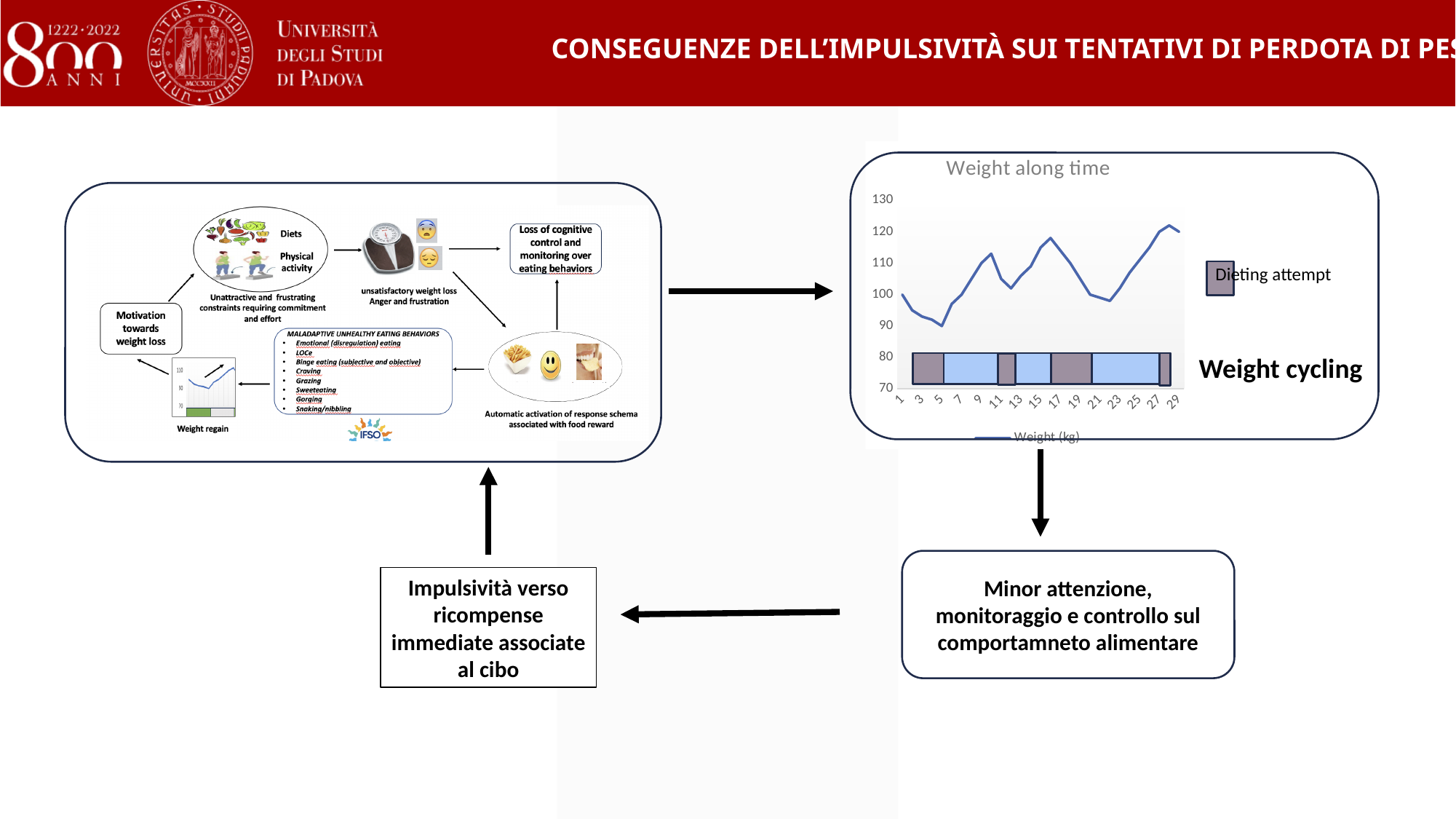
In the 'Weight along time' chart, is the value at x = 21 greater or less than 110? less In the 'Weight along time' chart, does the weight overall rise or fall from x = 1 to x = 29? rise In the 'Weight along time' chart, is the value at x = 15 greater or less than 110? greater What kind of chart is the 'Weight along time' chart? line chart In the 'Weight along time' chart, is the value at x = 29 greater or less than 110? greater In the 'Weight along time' chart, does the line rise or fall between x = 17 and x = 21? fall In the 'Weight along time' chart, is the value at x = 29 larger or smaller than the value at x = 5? larger What series name does the legend of the 'Weight along time' chart show? Weight (kg) What is the title of the chart on the right of the slide? Weight along time How many series does the legend of the 'Weight along time' chart list? 1